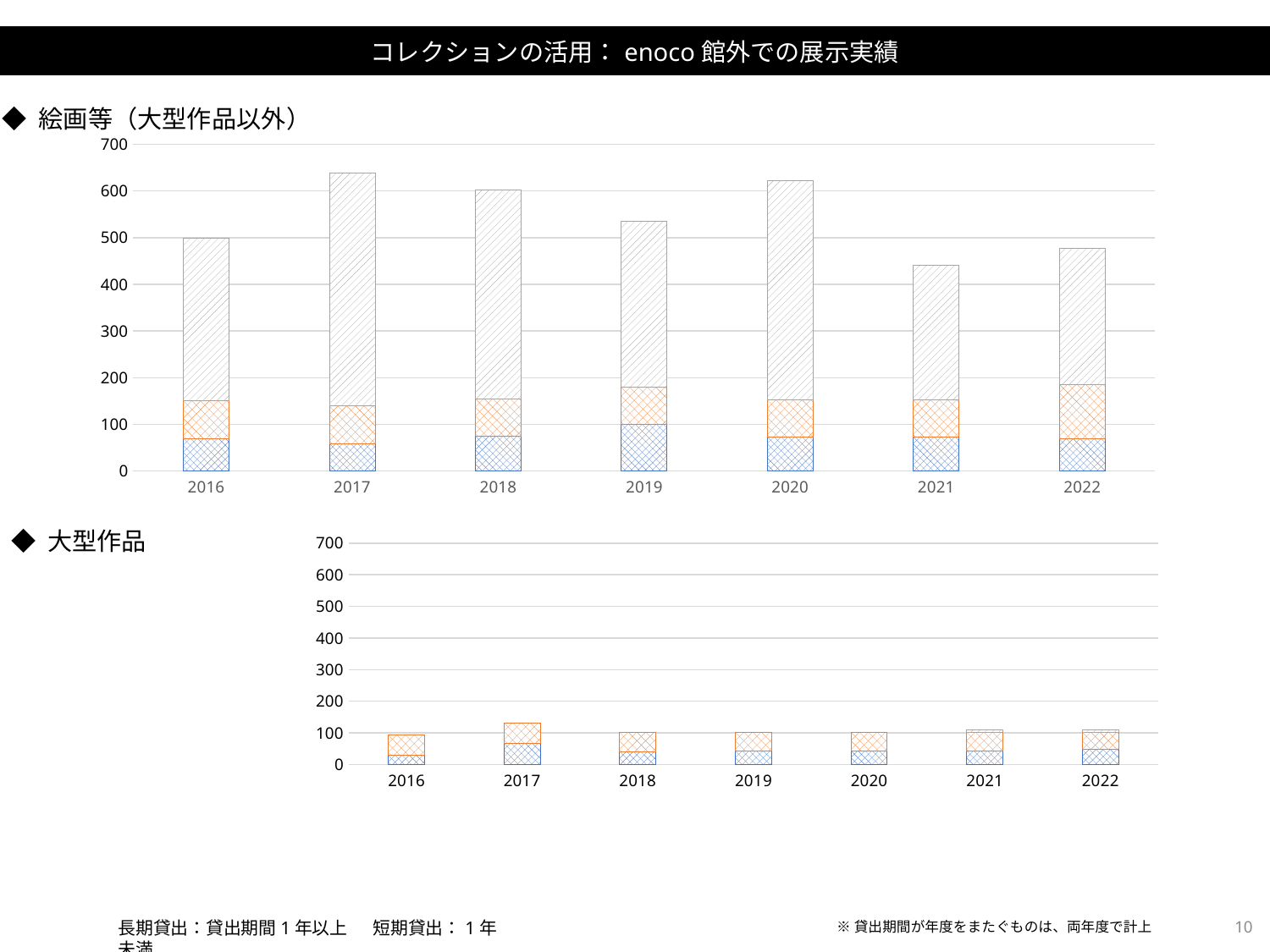
In the top chart (絵画等（大型作品以外）), is the total for 2019 greater or less than 500? greater In the top chart (絵画等（大型作品以外）), which year has the lowest total bar? 2021 In the top chart (絵画等（大型作品以外）), which total bar is taller, 2017 or 2021? 2017 In the top chart (絵画等（大型作品以外）), does the total rise or fall from 2020 to 2021? fall In the top chart (絵画等（大型作品以外）), is the total for 2017 greater or less than 600? greater In the bottom chart (大型作品), which year has the highest total bar? 2017 In the bottom chart (大型作品), is the total for 2017 greater or less than 100? greater In the bottom chart (大型作品), does the total rise or fall from 2016 to 2017? rise What kind of chart is the top chart titled 絵画等（大型作品以外）? stacked bar chart What is the first year shown on the x axis of the bottom chart (大型作品)? 2016 How many years are shown on the x axis of the top chart (絵画等（大型作品以外）)? 7